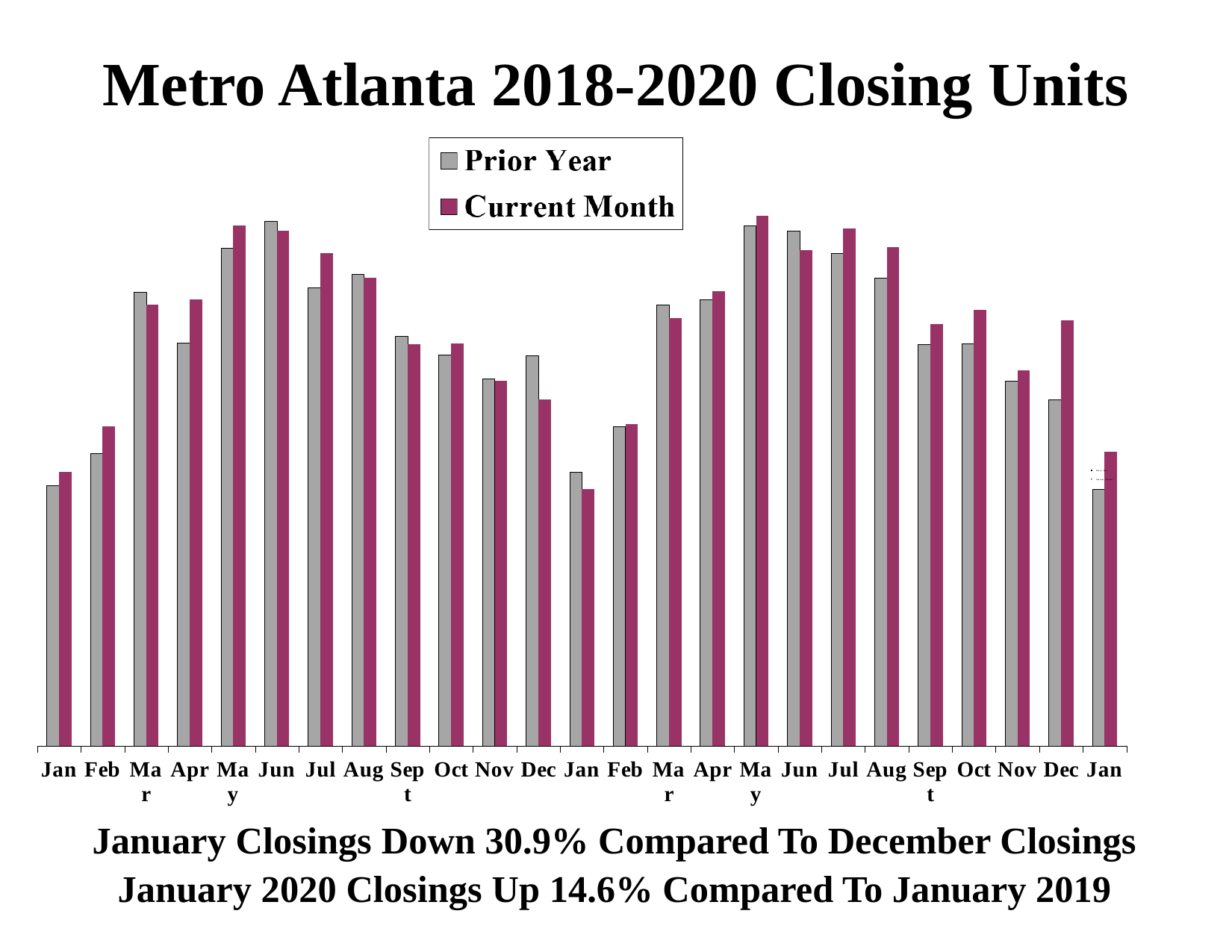
How many month categories are shown along the x axis? 25 Which month has the highest Current Month value? the second May In the second Dec, which is larger: Prior Year or Current Month? Current Month In the first Jun, which is larger: Prior Year or Current Month? Prior Year How many series does the legend list? 2 Do the Prior Year values rise or fall from the first Jan to the first Jun? rise Which month has the lowest Current Month value? the second Jan What are the two series named in the legend? Prior Year and Current Month What is the title of the chart? Metro Atlanta 2018-2020 Closing Units Do the Current Month values rise or fall from the first Jun to the first Nov? fall Which month has the highest Prior Year value? the first Jun What kind of chart is shown on the slide? bar chart